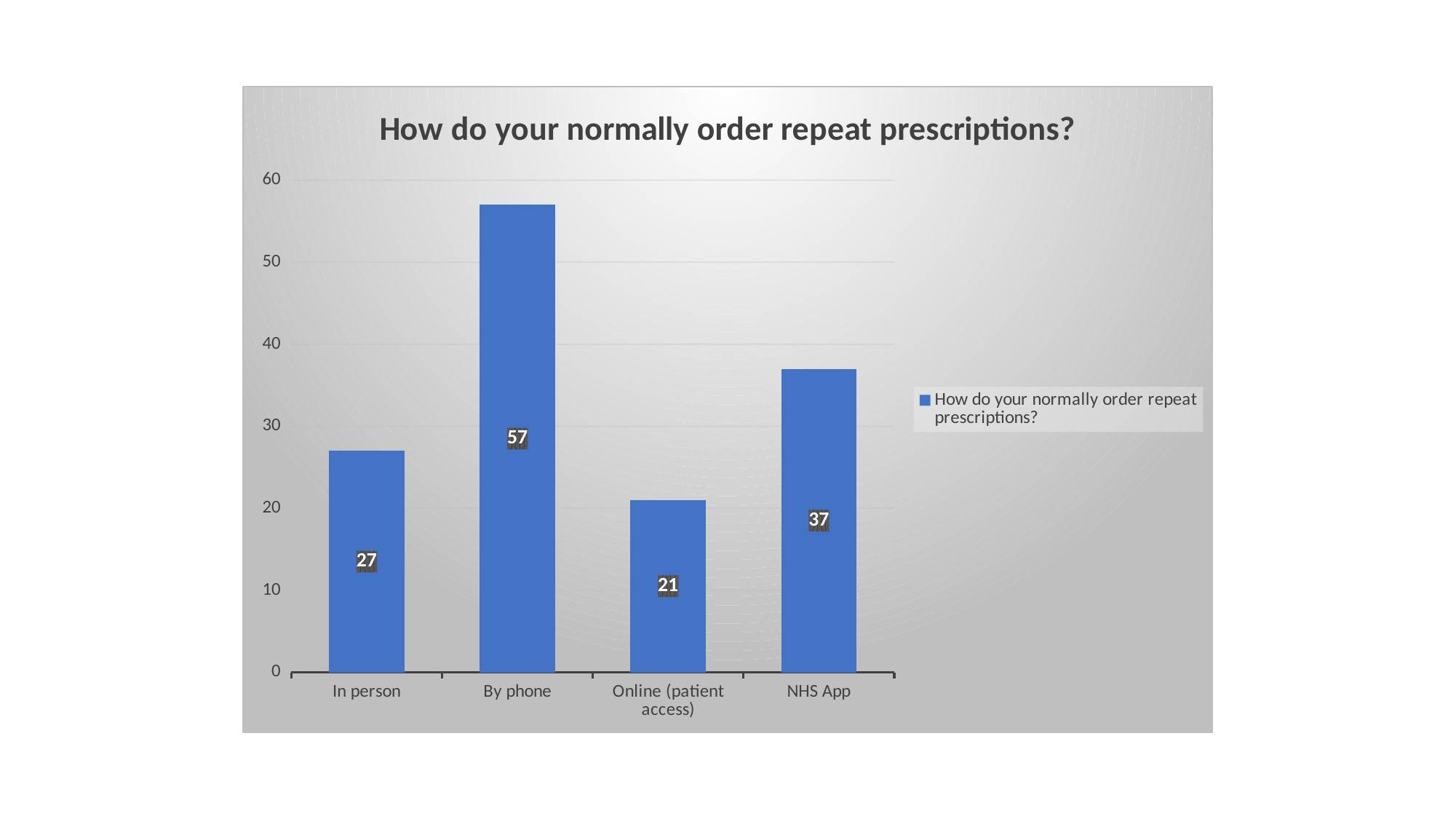
What is the value for By phone? 57 What is the title of the chart? How do your normally order repeat prescriptions? What is the difference between the values for By phone and NHS App? 20 What is the value for In person? 27 Is the value for NHS App greater or less than 40? less Which category has the lowest value? Online (patient access) How many categories are shown on the x axis? 4 What kind of chart is shown on the slide? bar chart What is the value for NHS App? 37 Which is larger, the value for In person or the value for Online (patient access)? In person Which category has the highest value? By phone What is the value for Online (patient access)? 21